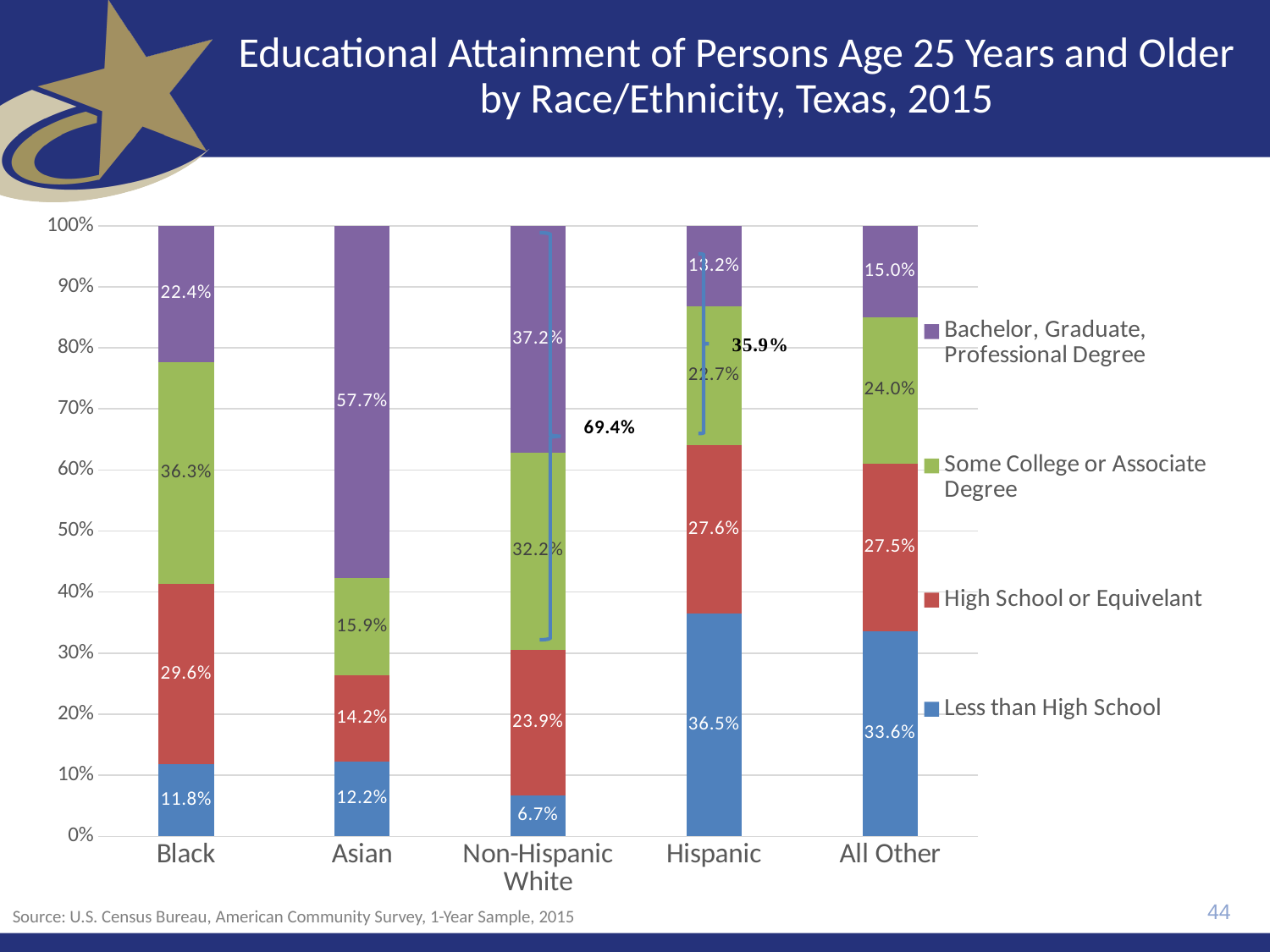
How many race/ethnicity categories are shown on the x axis? 5 What percentage of Hispanic persons age 25 and older have less than a high school education? 36.5% What is the value for Bachelor, Graduate, Professional Degree in the Asian bar? 57.7% Which has a larger High School or Equivelant share, Black or Non-Hispanic White? Black What is the High School or Equivelant value for the All Other category? 27.5% What is the title of the chart? Educational Attainment of Persons Age 25 Years and Older by Race/Ethnicity, Texas, 2015 How many series does the legend list? 4 What is the difference between the Some College or Associate Degree values for Black and Asian? 20.4 percentage points Which race/ethnicity category has the lowest share with Less than High School? Non-Hispanic White What kind of chart is shown on the slide? Stacked bar chart According to the annotation, what combined percentage of Non-Hispanic White persons have Some College or Associate Degree or higher? 69.4% Which race/ethnicity category has the highest share with a Bachelor, Graduate, Professional Degree? Asian